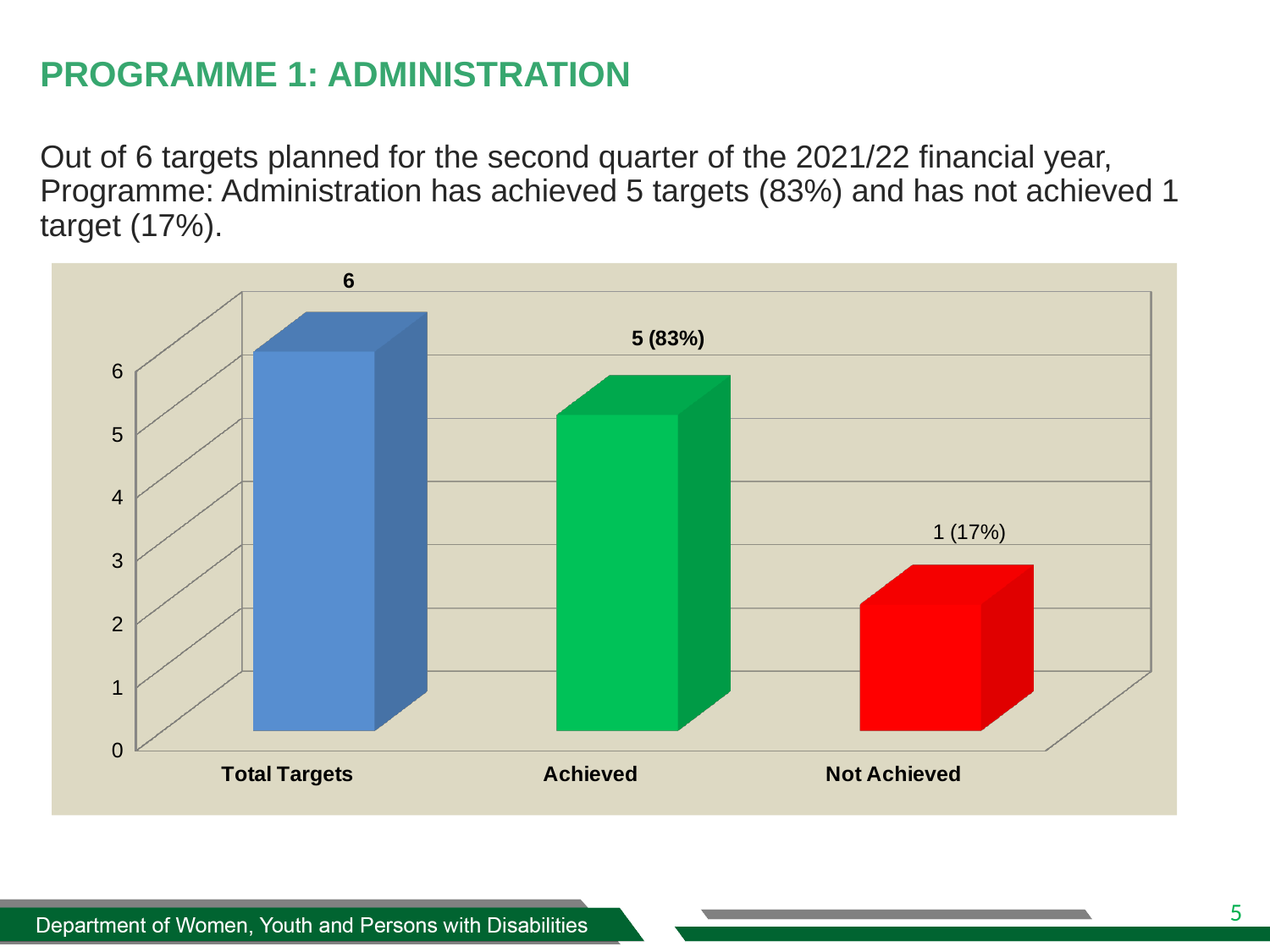
Which is larger, Achieved or Not Achieved? Achieved What kind of chart is shown on the slide? bar chart Which category has the lowest value? Not Achieved What is the data label shown on the Achieved bar? 5 (83%) What is the data label shown on the Not Achieved bar? 1 (17%) What colour is the Not Achieved bar? red How many categories are shown on the x axis? 3 What is the difference between the Achieved and Not Achieved values? 4 Is the value for Achieved greater or less than 3? greater What is the difference between Total Targets and Achieved? 1 What is the value for Total Targets? 6 Which category has the highest value? Total Targets